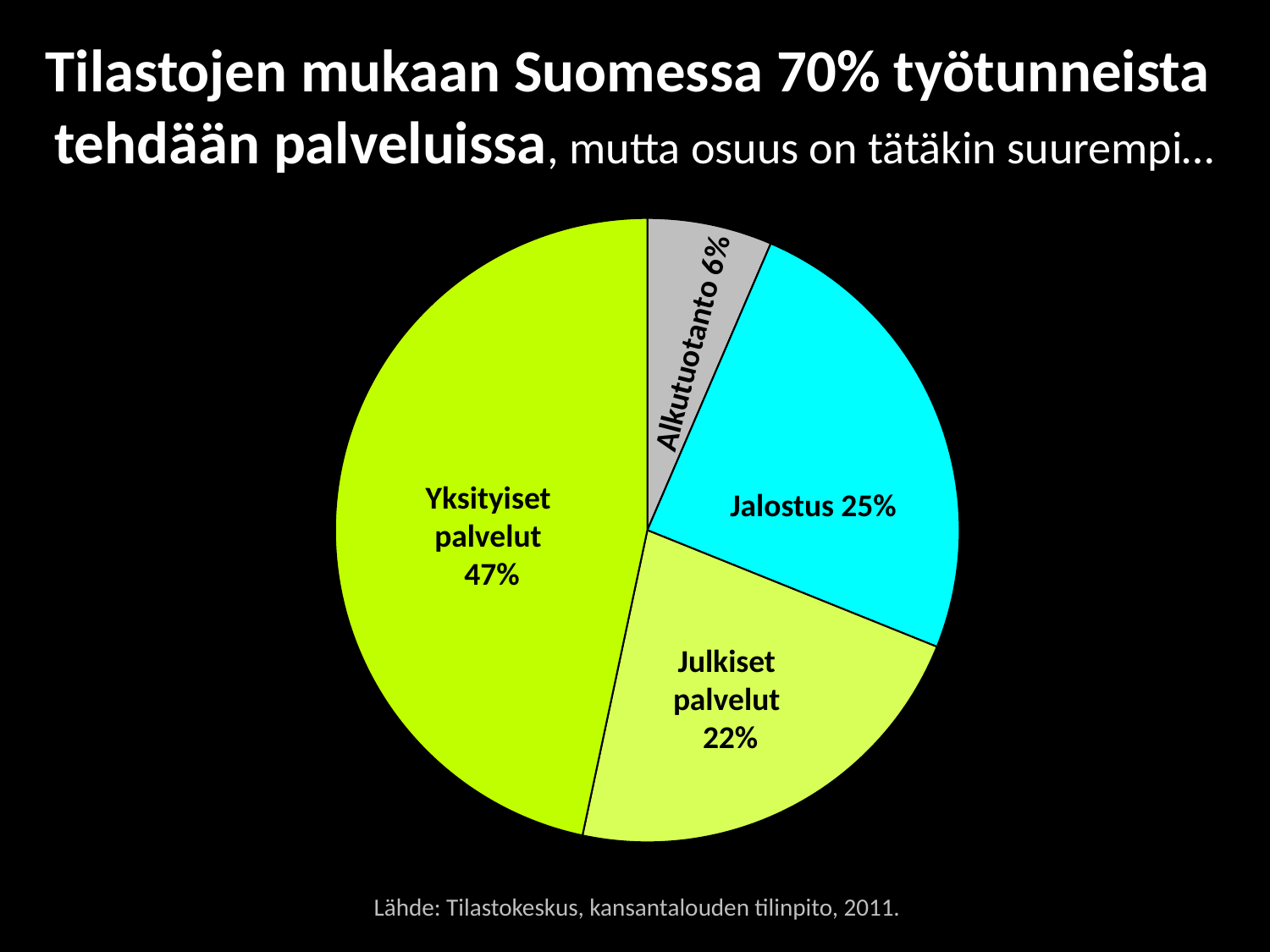
Which slice of the pie is the smallest? Alkutuotanto What share of the pie does Julkiset palvelut have? 22% Which is larger, the share of Jalostus or the share of Julkiset palvelut? Jalostus What is the difference between the shares of Yksityiset palvelut and Jalostus? 22 percentage points What kind of chart is shown on the slide? Pie chart What is the difference between the shares of Jalostus and Julkiset palvelut? 3 percentage points What colour is the Jalostus slice? Cyan What share of the pie does Yksityiset palvelut have? 47% How many slices does the pie chart have? 4 Which slice of the pie is the largest? Yksityiset palvelut What share of the pie does Alkutuotanto have? 6%